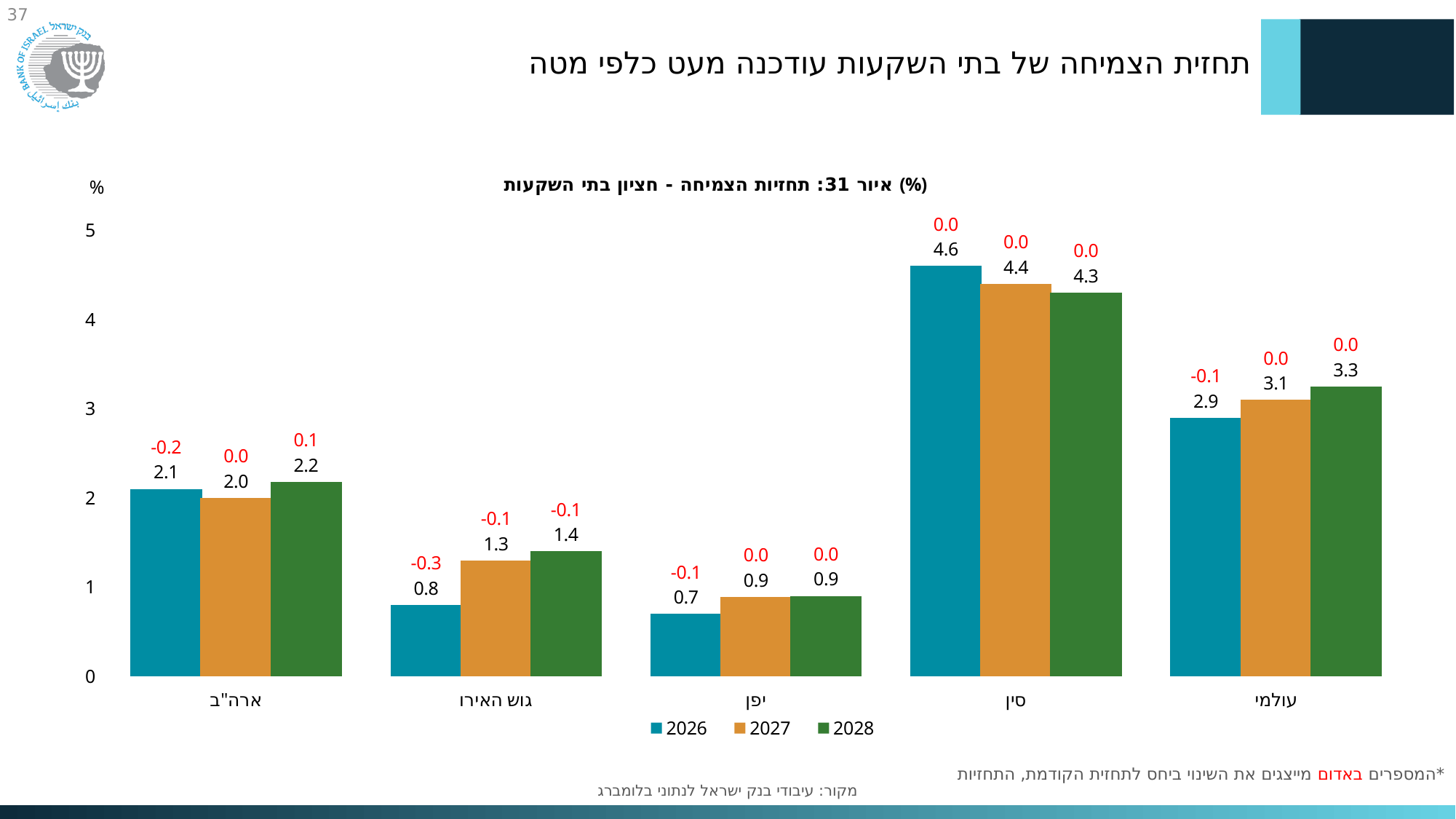
Which category has the highest 2026 value? סין Do the values for עולמי rise or fall from 2026 to 2028? rise What kind of chart is shown? bar chart How many series does the legend list? 3 What is the difference between the 2026 and 2028 values for סין? 0.3 Which category has the lowest 2028 value? יפן What is the red number shown above the 2026 bar for גוש האירו? -0.3 What is the 2027 value for גוש האירו? 1.3 What is the 2028 value for עולמי? 3.3 Which is larger: the 2027 value for ארה"ב or the 2027 value for עולמי? עולמי How many categories are shown on the x axis? 5 What is the 2026 value for סין? 4.6